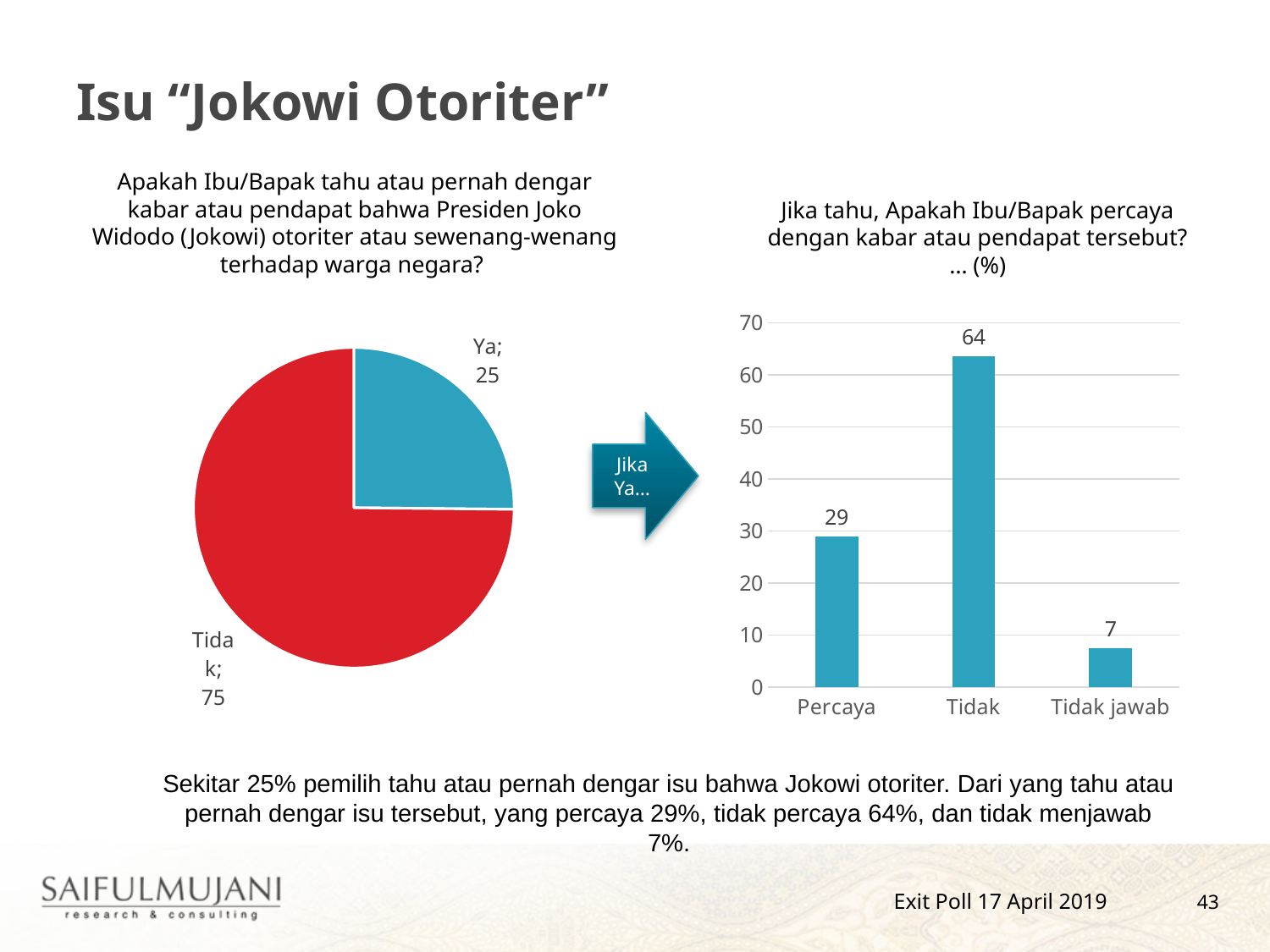
In the bar chart on the right, what is the value for Percaya? 29 In the bar chart on the right, what is the value for Tidak jawab? 7 What kind of chart is the chart on the right? bar chart In the bar chart on the right, which category has the highest value? Tidak In the pie chart on the left, which slice is larger, Ya or Tidak? Tidak In the pie chart on the left, how many slices are there? 2 In the bar chart on the right, which category has the lowest value? Tidak jawab In the pie chart on the left, what is the value for Tidak? 75 What kind of chart is the chart on the left? pie chart In the bar chart on the right, what is the difference between the values for Tidak and Percaya? 35 In the bar chart on the right, what is the value for Tidak? 64 In the pie chart on the left, what is the value for Ya? 25